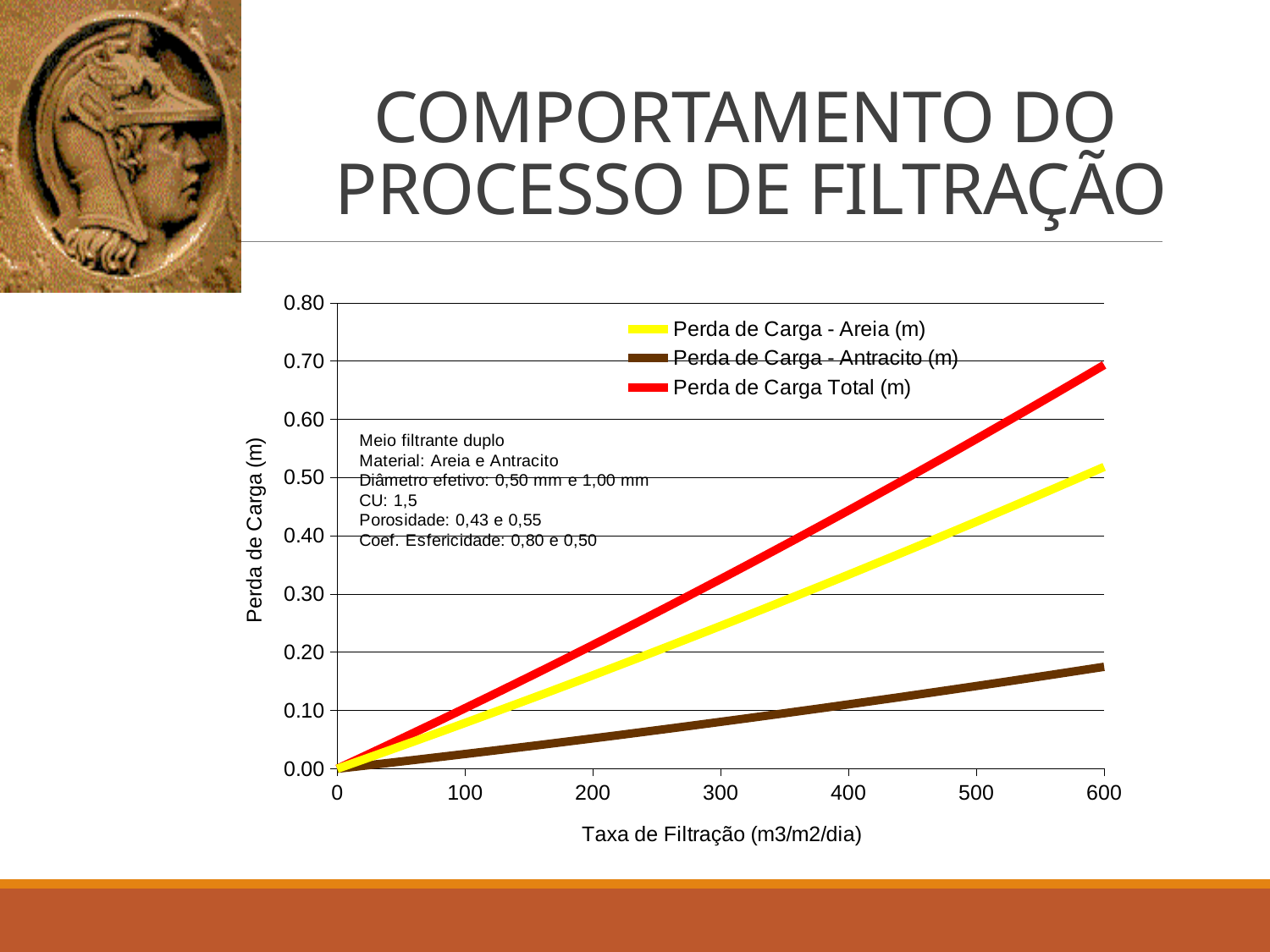
What kind of chart is shown on the slide? line chart Is the value of Perda de Carga - Antracito (m) at 600 m3/m2/dia greater or less than 0.20? less Is the value of Perda de Carga Total (m) at 600 m3/m2/dia greater or less than 0.60? greater Which series has the lowest value at a filtration rate of 600 m3/m2/dia? Perda de Carga - Antracito (m) Which series has the highest value at a filtration rate of 600 m3/m2/dia? Perda de Carga Total (m) Do the values of Perda de Carga Total (m) rise or fall as the filtration rate increases? rise Is the value of Perda de Carga Total (m) at 300 m3/m2/dia greater or less than 0.30? greater Which is larger at 400 m3/m2/dia: Perda de Carga - Areia (m) or Perda de Carga - Antracito (m)? Perda de Carga - Areia (m) How many series does the legend list? 3 What colour is the line for Perda de Carga - Areia (m)? yellow What is the label of the x axis? Taxa de Filtração (m3/m2/dia)